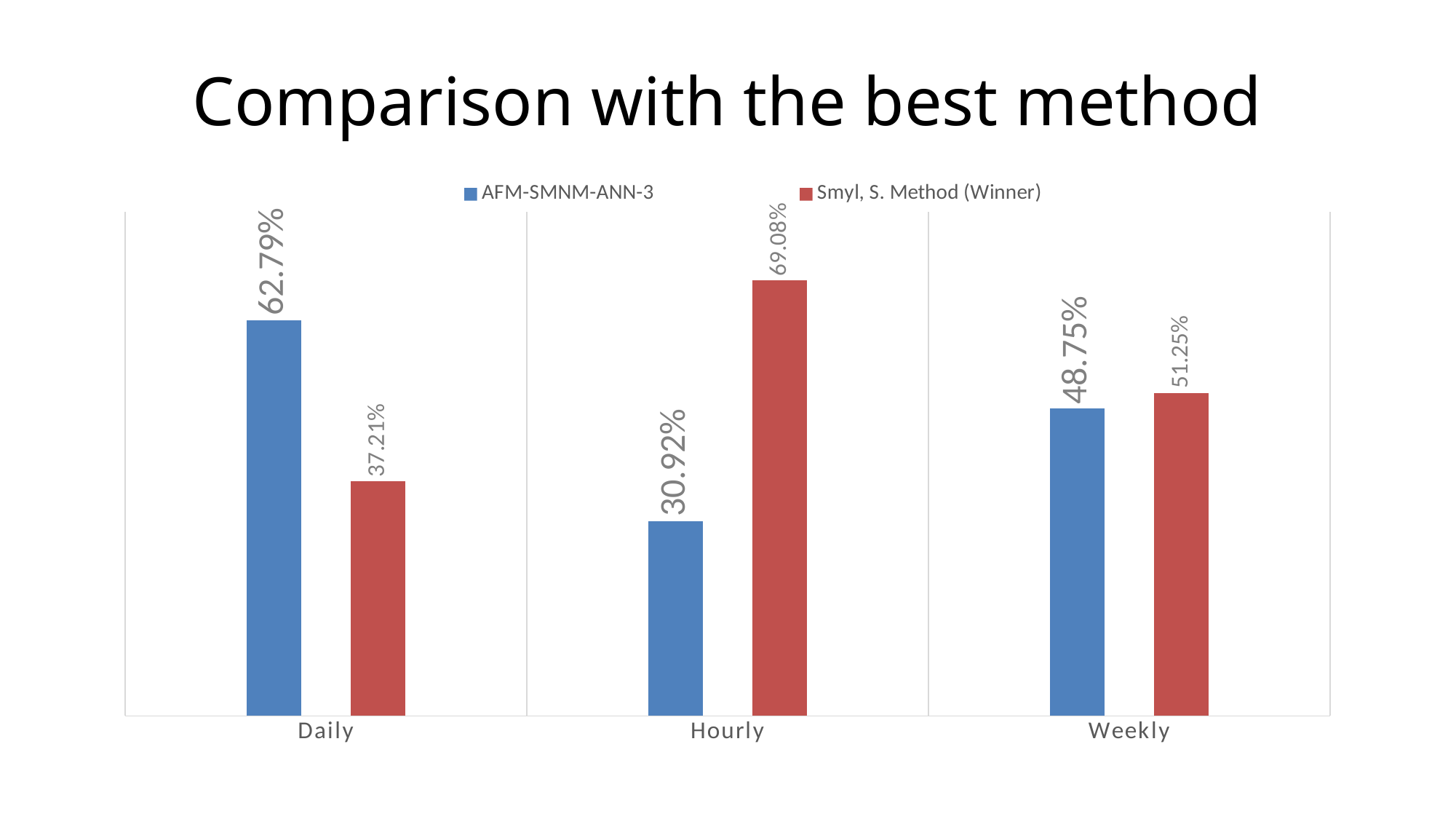
How many categories are shown on the x axis? 3 What is the difference between the Smyl, S. Method (Winner) and AFM-SMNM-ANN-3 values in the Hourly category? 38.16% What is the value for AFM-SMNM-ANN-3 in the Daily category? 62.79% What is the value for AFM-SMNM-ANN-3 in the Weekly category? 48.75% How many series does the legend list? 2 Which series has the larger value in the Daily category? AFM-SMNM-ANN-3 What is the value for Smyl, S. Method (Winner) in the Daily category? 37.21% What kind of chart is shown on the slide? Bar chart In which category does AFM-SMNM-ANN-3 have its lowest value? Hourly Which series has the larger value in the Weekly category? Smyl, S. Method (Winner) In which category does AFM-SMNM-ANN-3 have its highest value? Daily What is the value for Smyl, S. Method (Winner) in the Hourly category? 69.08%